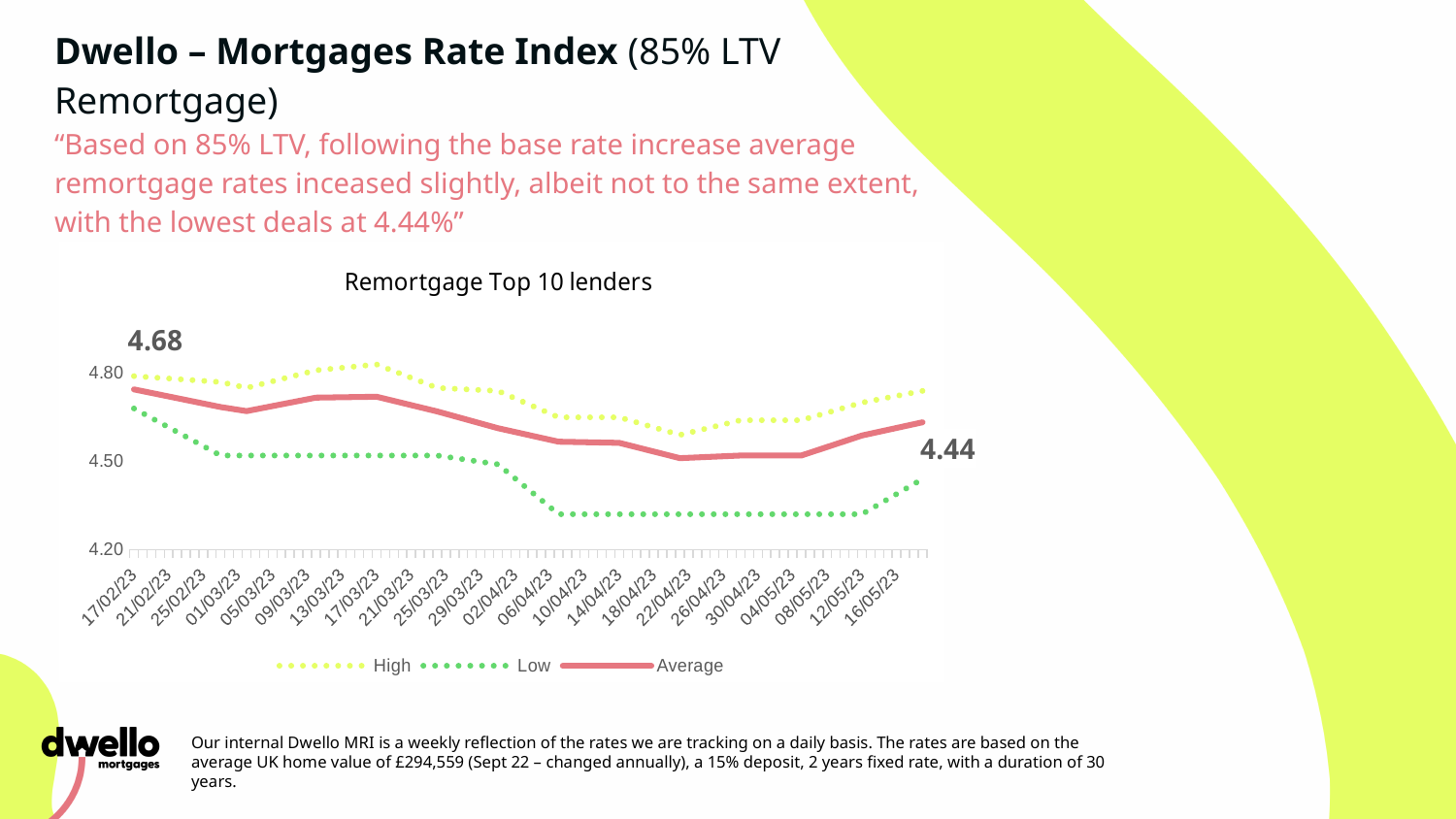
Is the value of the High series at 22/04/23 greater or less than 4.80? less How many series does the chart legend list? 3 Which series has the highest values across the chart? High Is the value of the Low series at 10/04/23 greater or less than 4.50? less What is the first data label shown at the start of the chart? 4.68 What kind of chart is shown on the slide? Line chart Does the Low series rise or fall from 17/02/23 to 16/05/23? Fall How many date labels are shown on the x axis? 23 What is the title of the chart? Remortgage Top 10 lenders Is the value of the Average series at 17/02/23 greater or less than 4.50? greater Which series are listed in the chart legend? High, Low, Average What value does the Low series show at 16/05/23? 4.44